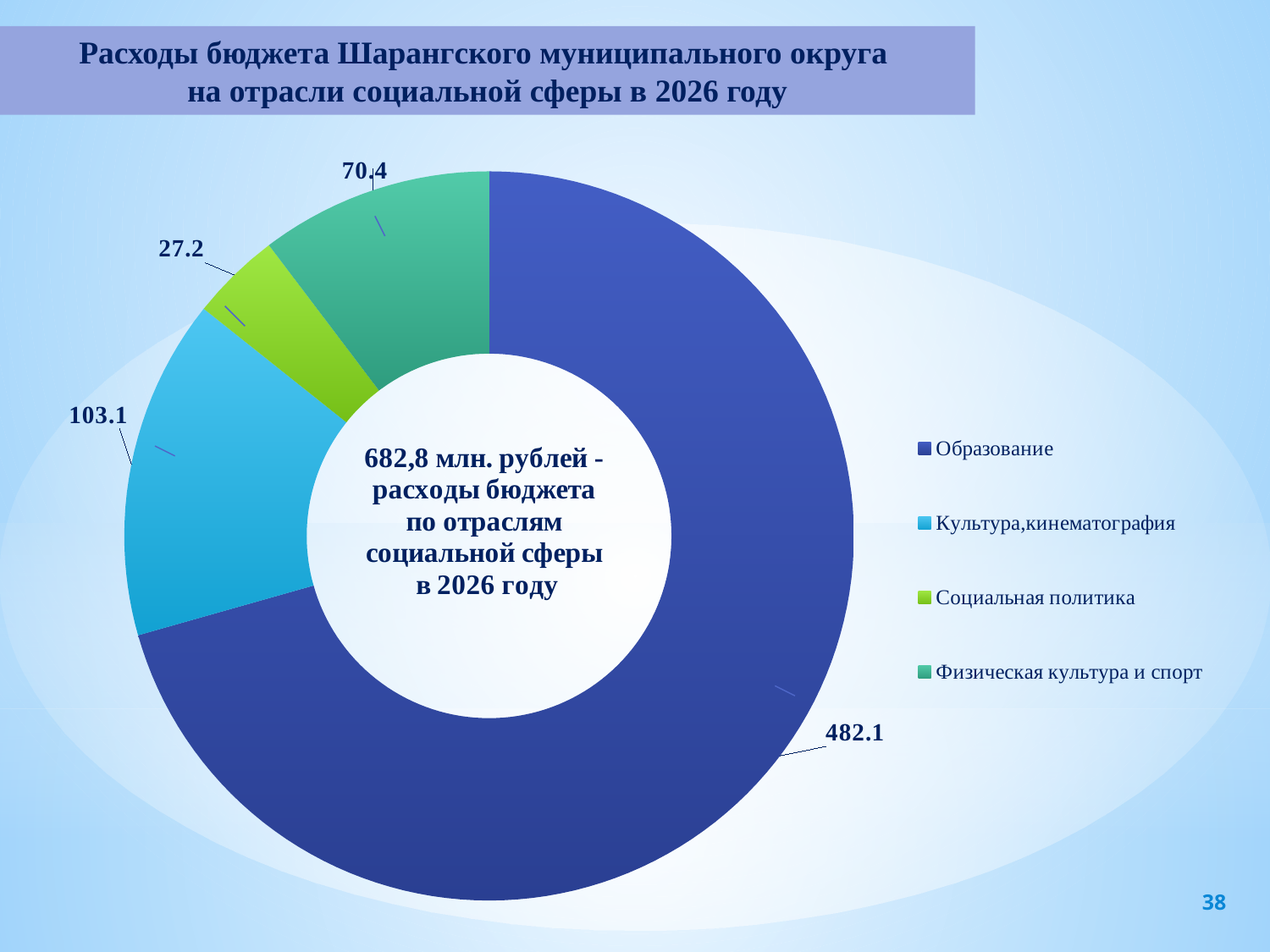
How many categories does the chart show? 4 What is the value for Социальная политика? 27.2 Which category has the smallest value? Социальная политика Which category has the largest value? Образование What is the value for Образование? 482.1 What total amount is stated in the centre of the chart? 682,8 млн. рублей What is the value for Культура,кинематография? 103.1 What is the value for Физическая культура и спорт? 70.4 What is the difference between the values for Физическая культура и спорт and Социальная политика? 43.2 What kind of chart is shown on the slide? Doughnut chart Which is larger: Культура,кинематография or Физическая культура и спорт? Культура,кинематография What is the difference between the values for Образование and Культура,кинематография? 379.0